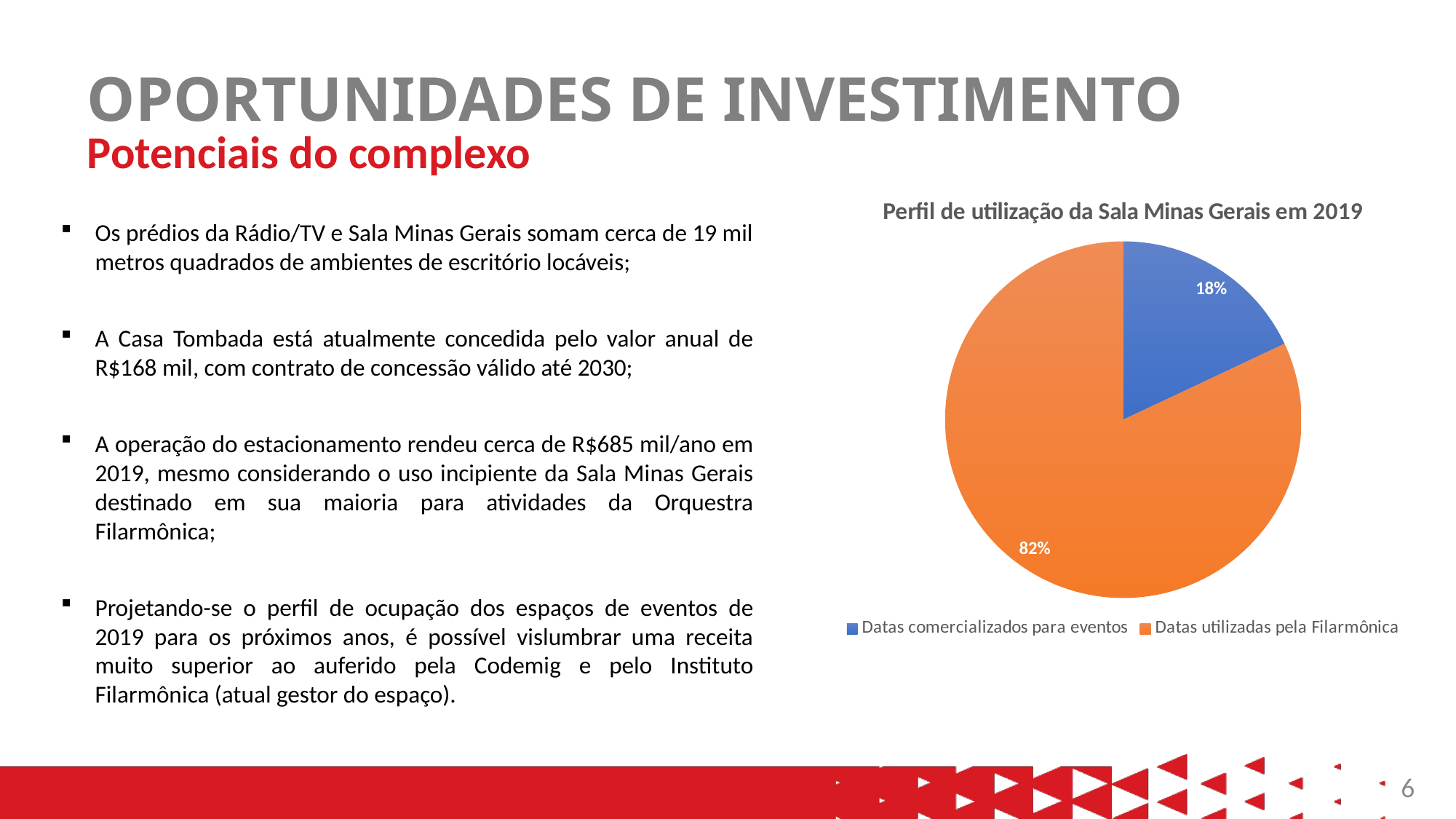
What kind of chart is shown on the slide? Pie chart Which category has the smallest slice of the pie? Datas comercializados para eventos How many entries does the legend list? 2 What colour is the slice for 'Datas comercializados para eventos'? Blue What share of the pie is 'Datas comercializados para eventos'? 18% What is the difference in percentage points between 'Datas utilizadas pela Filarmônica' and 'Datas comercializados para eventos'? 64 percentage points What share of the pie is 'Datas utilizadas pela Filarmônica'? 82% How many categories does the pie chart have? 2 Which is larger: 'Datas comercializados para eventos' or 'Datas utilizadas pela Filarmônica'? Datas utilizadas pela Filarmônica Which category has the largest slice of the pie? Datas utilizadas pela Filarmônica What is the title of the chart? Perfil de utilização da Sala Minas Gerais em 2019